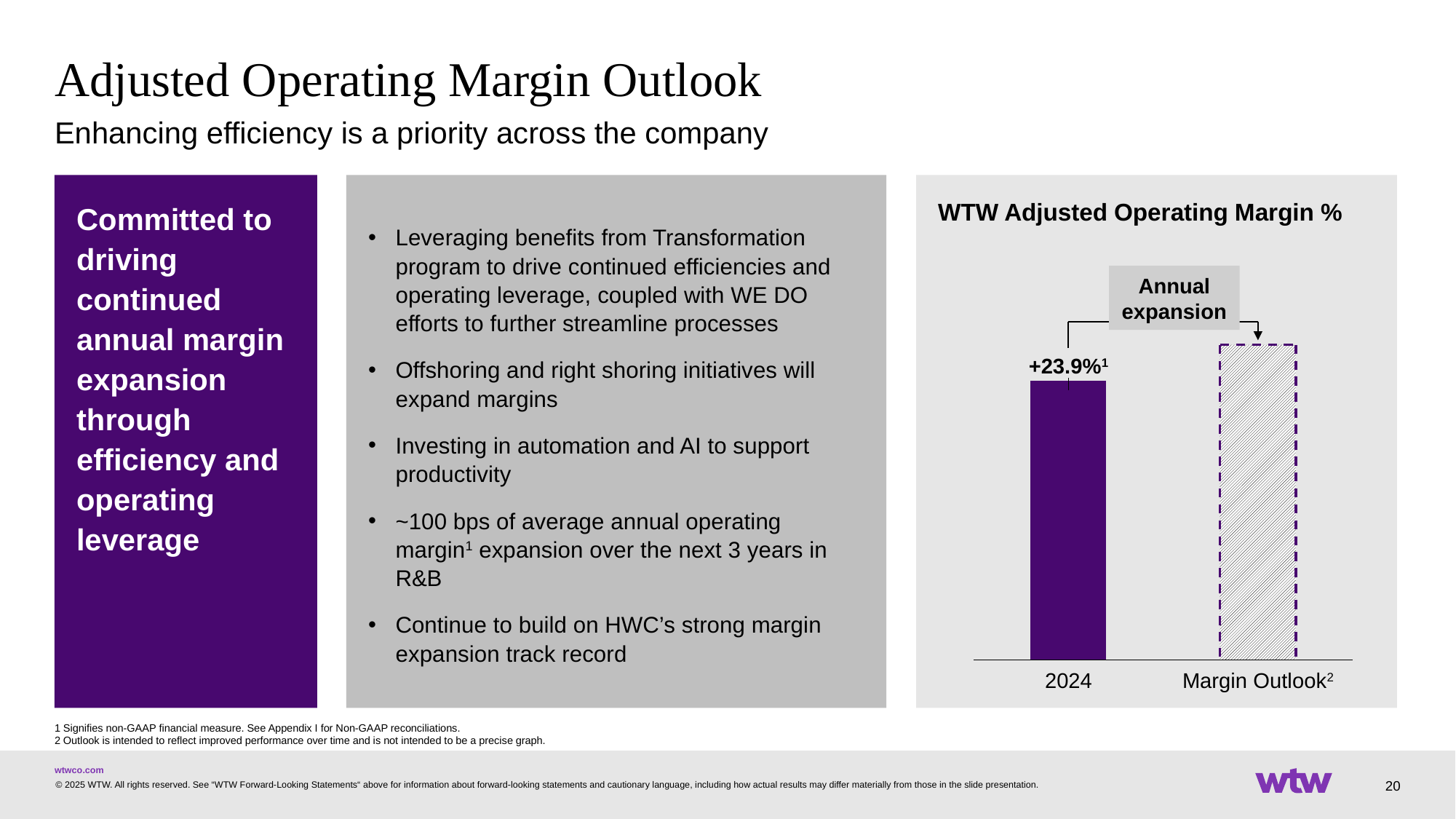
What is the value shown for 2024 in the WTW Adjusted Operating Margin % chart? +23.9% What is the title of the chart on the slide? WTW Adjusted Operating Margin % Which category has the lowest bar in the WTW Adjusted Operating Margin % chart? 2024 What kind of chart is the WTW Adjusted Operating Margin % chart? bar chart How many bars are shown in the WTW Adjusted Operating Margin % chart? 2 Which bar is taller in the WTW Adjusted Operating Margin % chart, 2024 or Margin Outlook? Margin Outlook Do the bars rise or fall from 2024 to Margin Outlook in the WTW Adjusted Operating Margin % chart? rise What label is shown in the box above the arrow between the two bars in the chart? Annual expansion Which category has the highest bar in the WTW Adjusted Operating Margin % chart? Margin Outlook